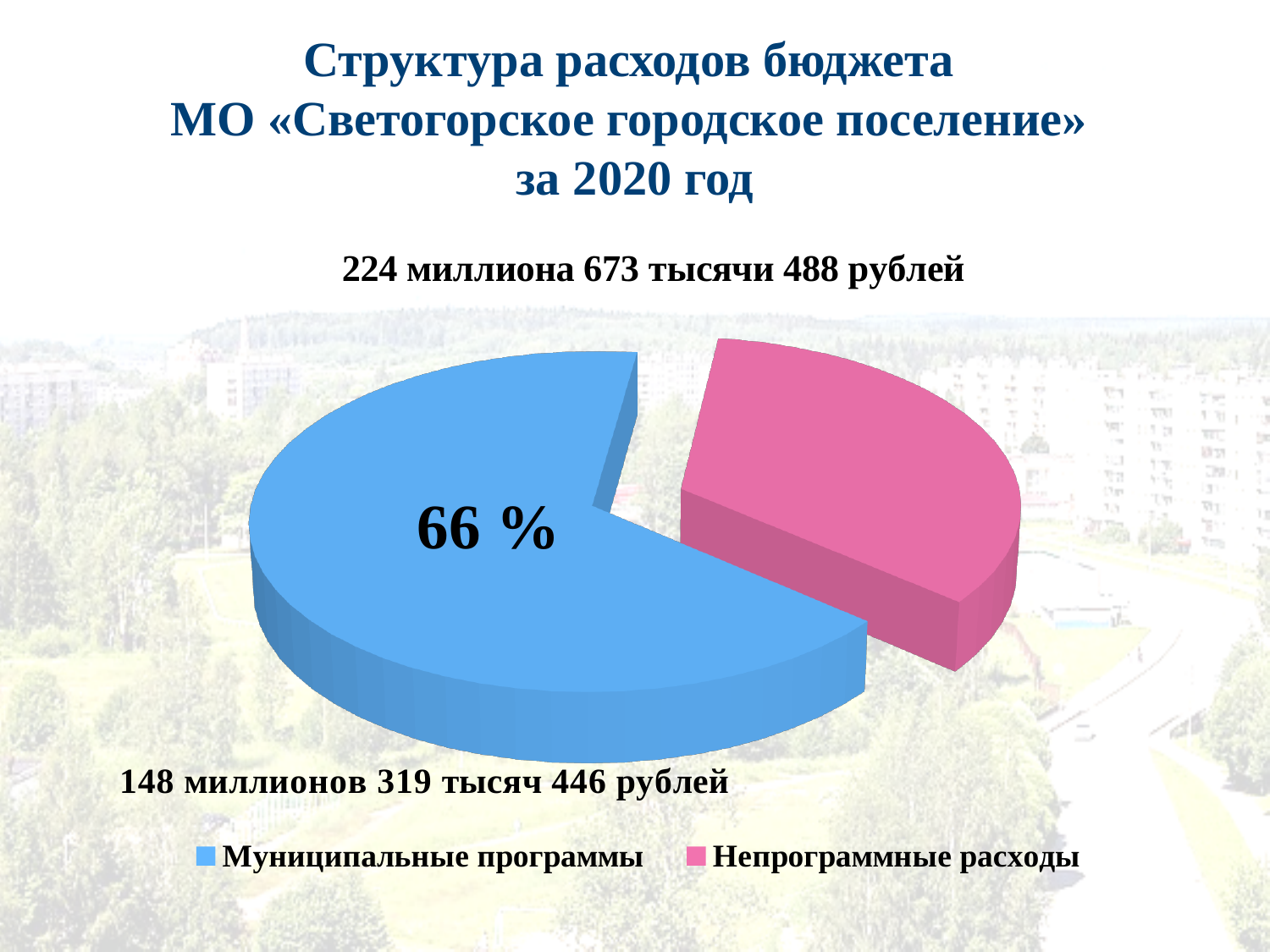
What is the total amount of budget expenditures shown on the slide? 224 миллиона 673 тысячи 488 рублей What amount is shown for Муниципальные программы? 148 миллионов 319 тысяч 446 рублей Is the share of Муниципальные программы greater or less than 50%? greater What kind of chart is shown on the slide? pie chart How many slices does the pie chart have? 2 What colour represents Непрограммные расходы in the pie chart? pink What share of the pie does Муниципальные программы take? 66 % Which category has the smallest slice of the pie? Непрограммные расходы How many entries does the legend list? 2 Which category has the largest slice of the pie? Муниципальные программы For which year does the chart show the budget expenditure structure? 2020 Which is larger: Муниципальные программы or Непрограммные расходы? Муниципальные программы